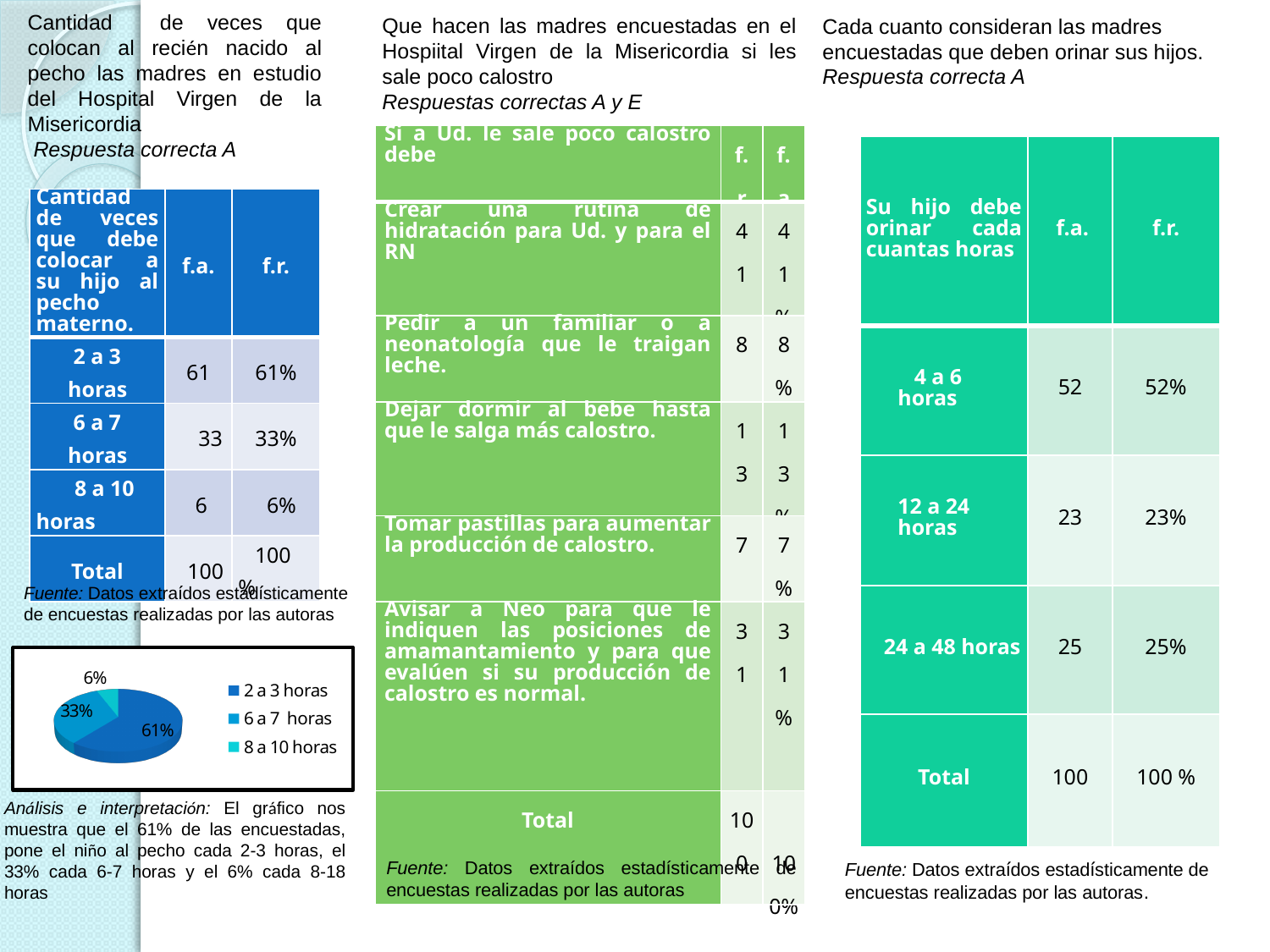
What kind of chart is shown on the slide? pie chart In the pie chart, what is the difference in percentage points between the "6 a 7 horas" slice and the "8 a 10 horas" slice? 27 What share of the pie chart does the "2 a 3 horas" slice represent? 61% Which legend entry in the pie chart is shown in the lightest blue colour? 8 a 10 horas How many entries does the pie chart legend list? 3 What share of the pie chart does the "6 a 7 horas" slice represent? 33% In the pie chart, which slice is larger: "6 a 7 horas" or "8 a 10 horas"? 6 a 7 horas What share of the pie chart does the "8 a 10 horas" slice represent? 6% Which category has the smallest slice in the pie chart? 8 a 10 horas Which category has the largest slice in the pie chart? 2 a 3 horas In the pie chart, what is the difference in percentage points between the "2 a 3 horas" slice and the "6 a 7 horas" slice? 28 How many slices does the pie chart have? 3